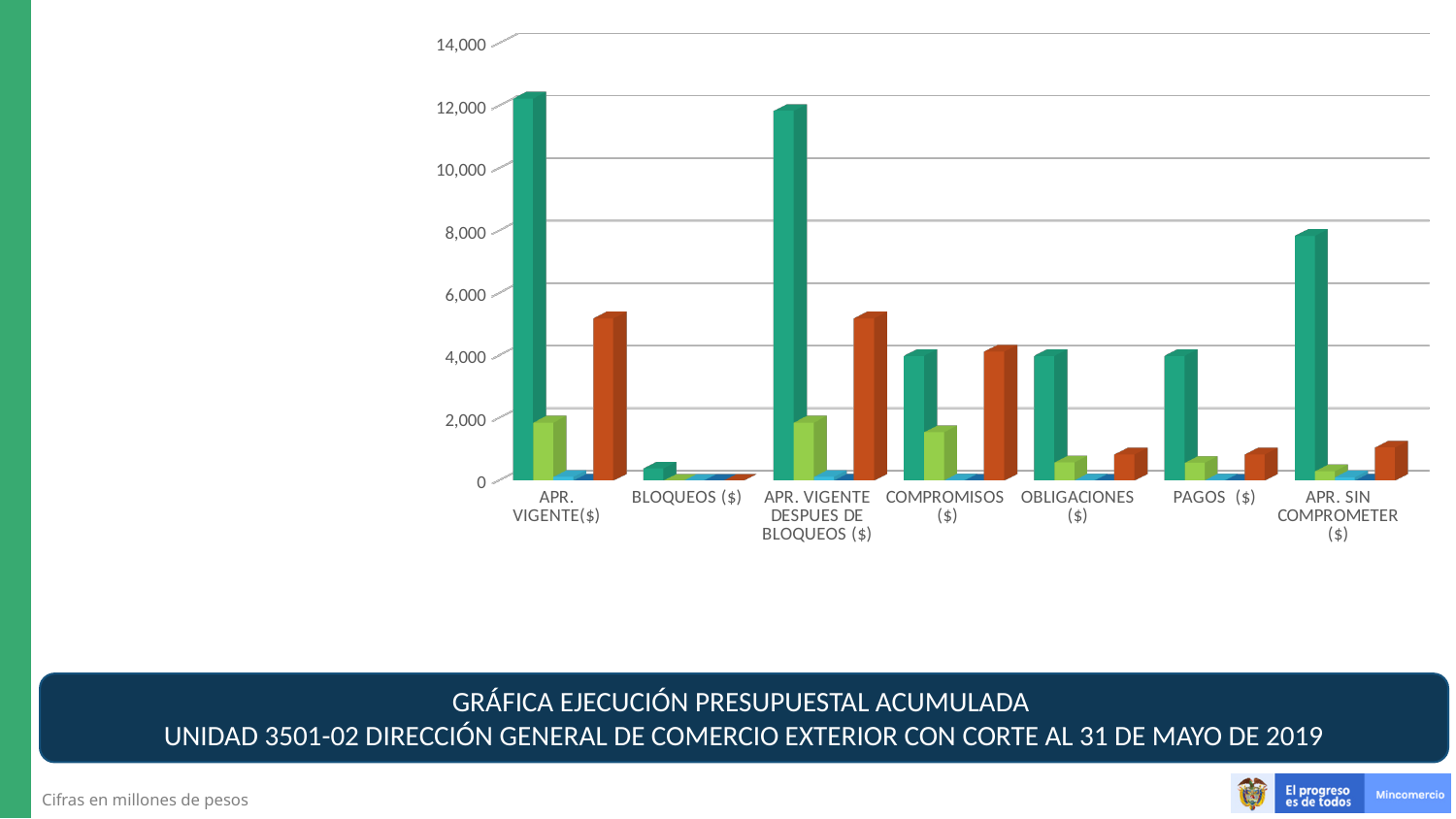
According to the note at the bottom of the slide, in what units are the figures expressed? Millones de pesos Is the orange bar for APR. VIGENTE($) greater or less than 4,000? greater What kind of chart is shown on the slide? bar chart Is the tallest (teal) bar for COMPROMISOS ($) greater or less than 6,000? less Is the tallest (teal) bar for APR. VIGENTE DESPUES DE BLOQUEOS ($) greater or less than 10,000? greater How many categories are shown along the x axis of the chart? 7 Which is larger: the orange bar for COMPROMISOS ($) or the orange bar for PAGOS ($)? COMPROMISOS ($) Which category contains the tallest bar in the chart? APR. VIGENTE($) Which category has the shortest bars overall in the chart? BLOQUEOS ($) Which is larger: the teal bar for APR. VIGENTE($) or the teal bar for APR. SIN COMPROMETER ($)? APR. VIGENTE($)